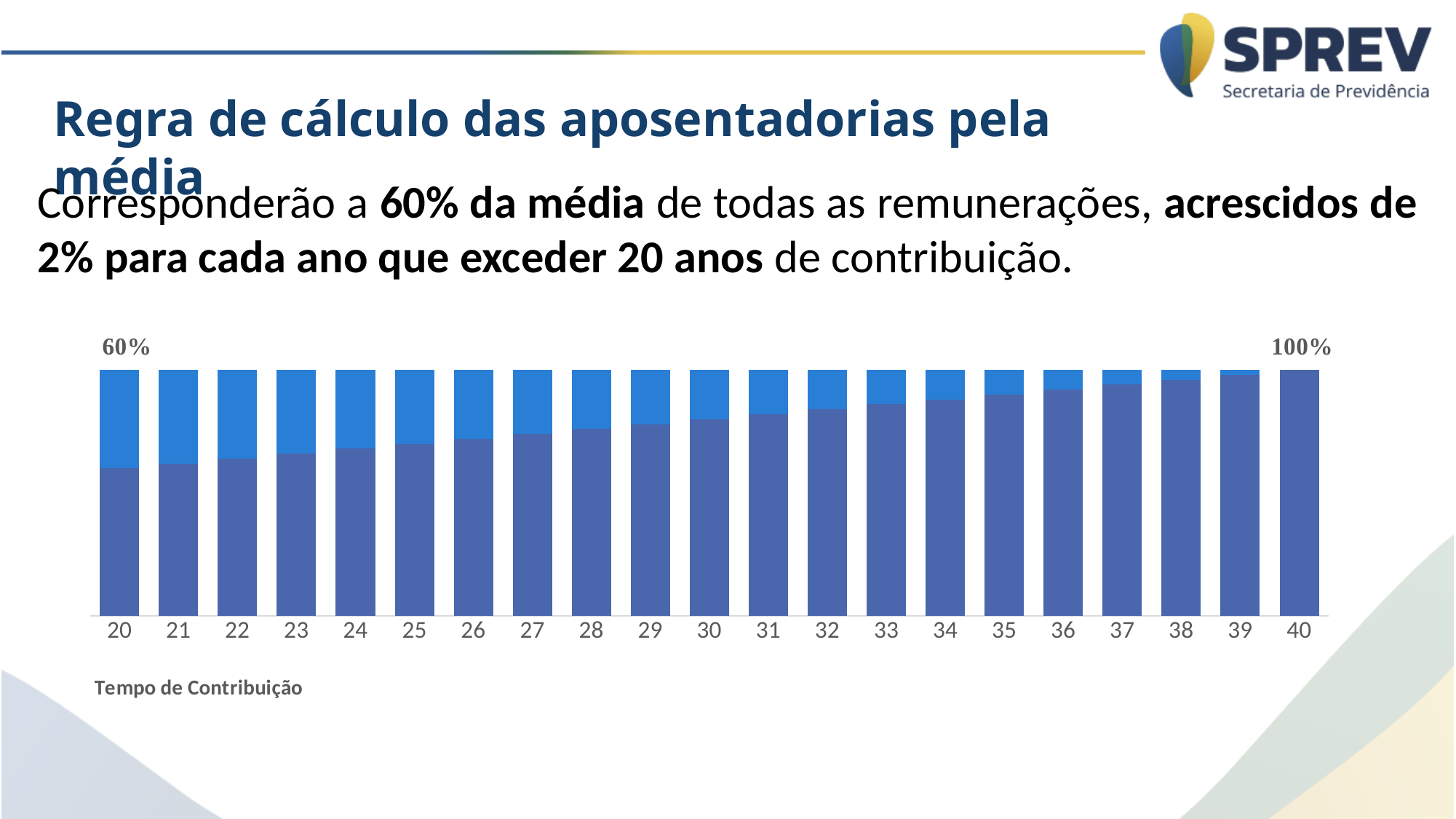
What is the first category on the x axis of the chart? 20 Which contribution-time category has the smallest dark blue portion? 20 What is the x-axis title of the chart? Tempo de Contribuição Which has the larger dark blue portion: the bar for 20 or the bar for 40? 40 What kind of chart is shown on the slide? bar chart What value is labelled above the bar for 40 years of contribution? 100% Which contribution-time category has the largest dark blue portion? 40 How many contribution-time categories are shown along the x axis of the chart? 21 What value is labelled above the bar for 20 years of contribution? 60% What is the difference between the labelled value at 40 years and the labelled value at 20 years of contribution? 40% Does the dark blue portion of the bars rise or fall as contribution time increases from 20 to 40? rise